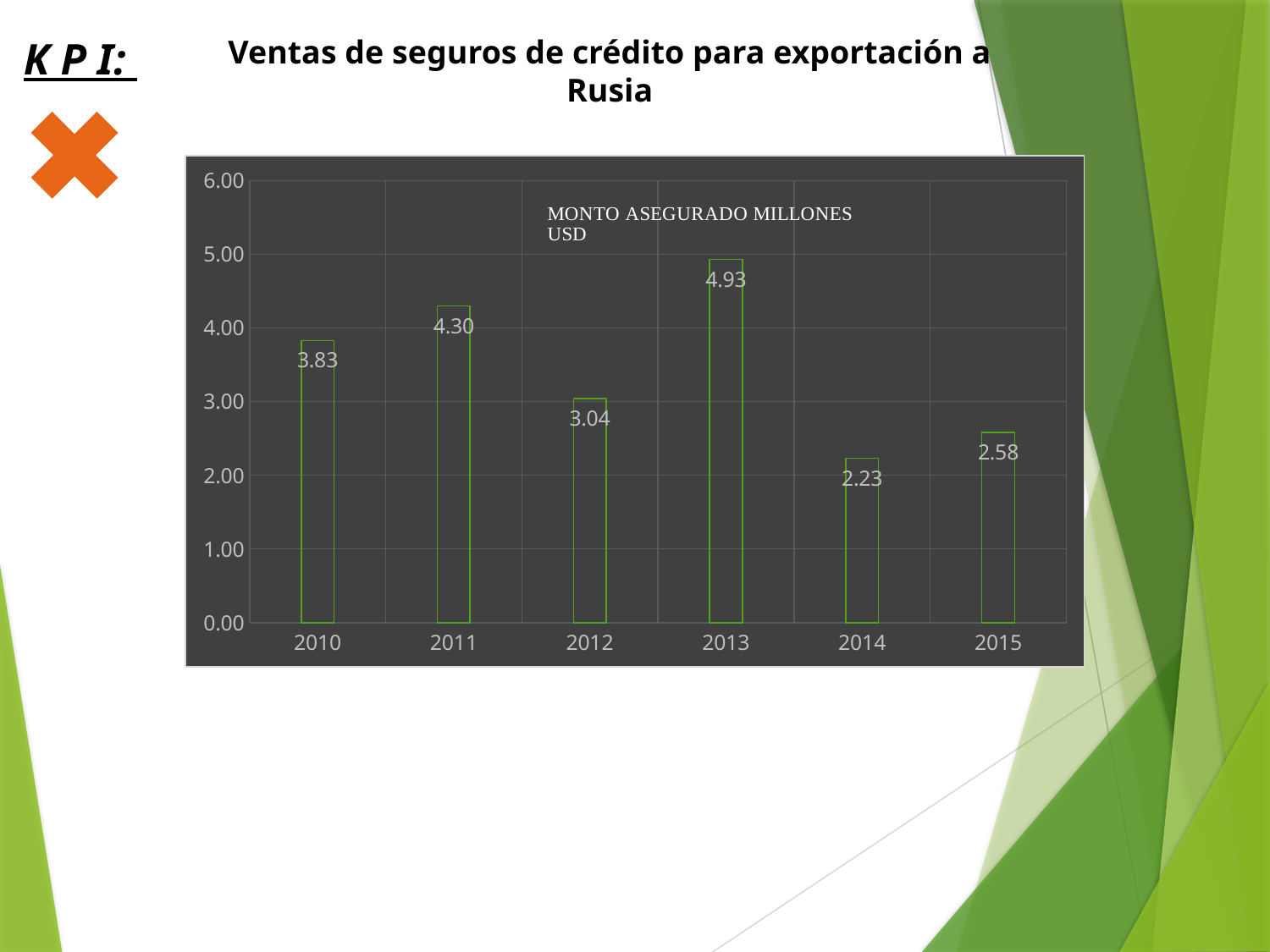
Is the value for 2014 greater or less than 3.00? less What is the difference between the values for 2011 and 2012? 1.26 Which year has the highest value? 2013 What is the value for 2015? 2.58 What is the title of the chart? Ventas de seguros de crédito para exportación a Rusia What kind of chart is shown? bar chart What is the value for 2013? 4.93 How many years are shown on the x axis? 6 Which is larger, the value for 2010 or the value for 2015? 2010 Which year has the lowest value? 2014 Do the values rise or fall from 2013 to 2014? fall What is the value for 2010? 3.83